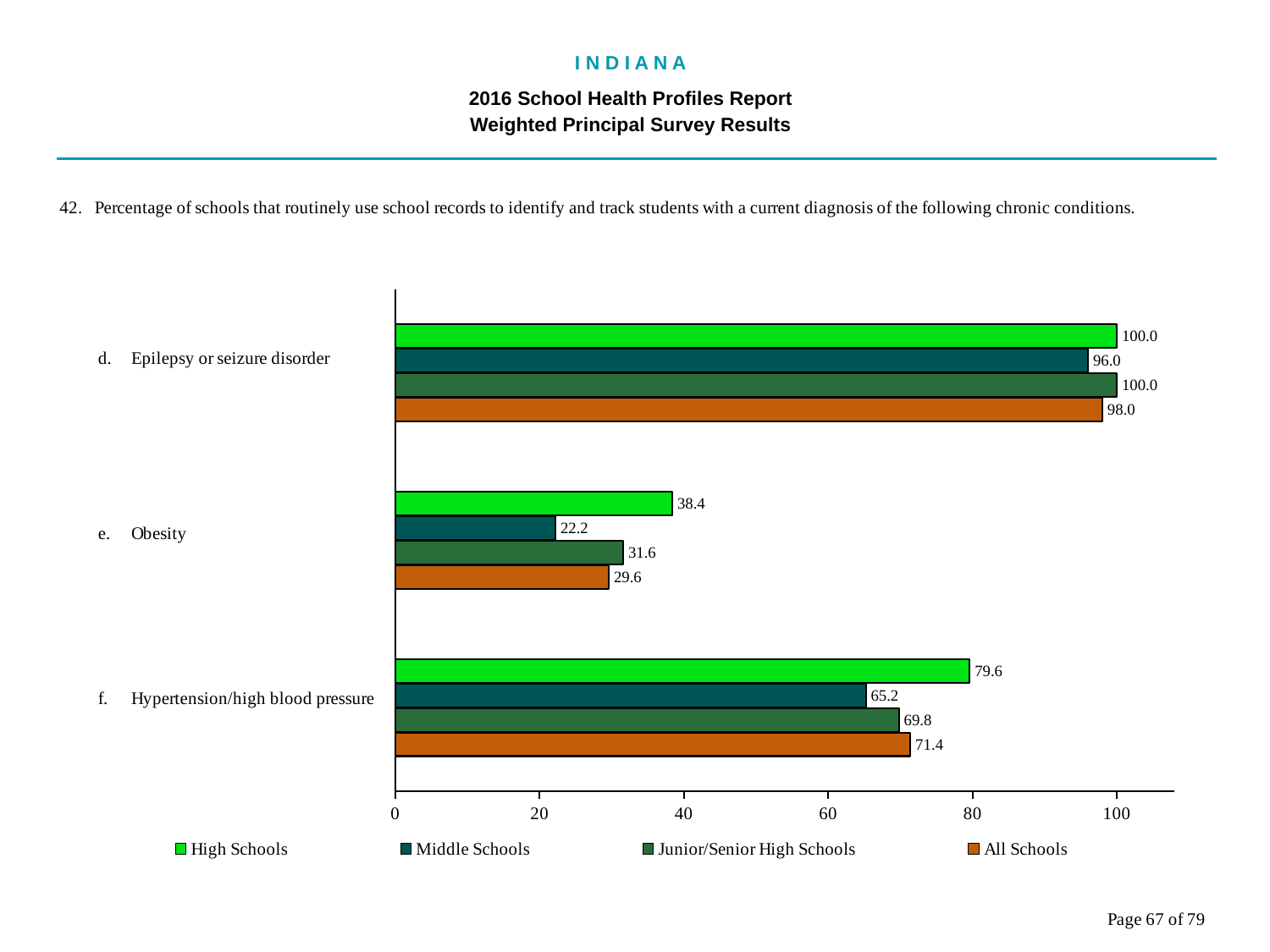
What is the difference between the High Schools and Middle Schools values for Obesity? 16.2 Is the value for All Schools for Obesity greater or less than 40? less How many chronic conditions are shown on the chart? 3 Which category has the lowest value for Middle Schools? Obesity What is the value for Middle Schools for Hypertension/high blood pressure? 65.2 What is the value for All Schools for Epilepsy or seizure disorder? 98.0 What is the value for Junior/Senior High Schools for Obesity? 31.6 Which is larger for Hypertension/high blood pressure: Junior/Senior High Schools or All Schools? All Schools What kind of chart is shown on the slide? bar chart What is the value for High Schools for Obesity? 38.4 Which school type has the highest value for Hypertension/high blood pressure? High Schools How many series does the legend list? 4